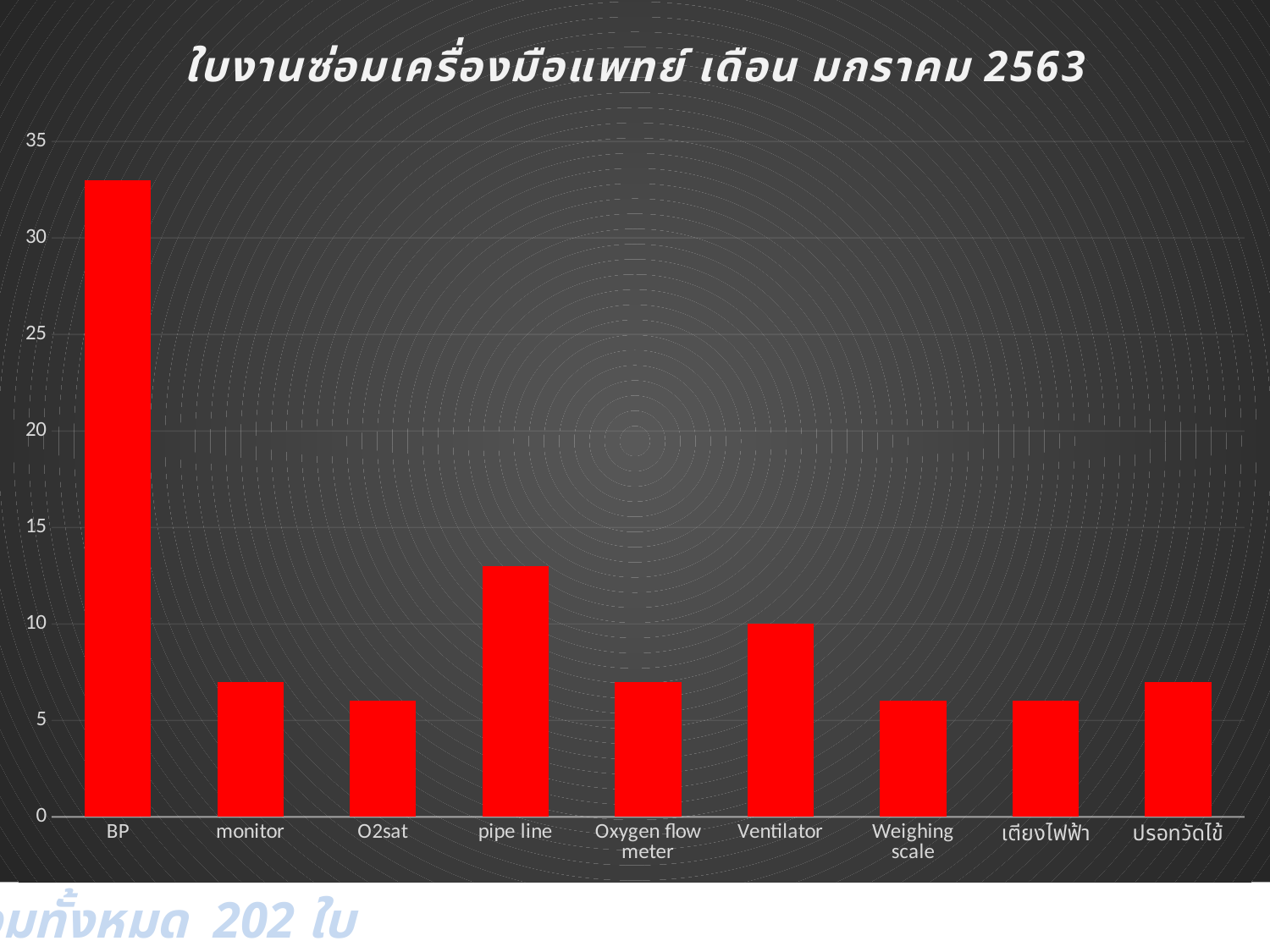
Which is larger, the value for Ventilator or the value for monitor? Ventilator How many categories are shown on the x axis? 9 Which is larger, the value for pipe line or the value for Ventilator? pipe line What type of chart is shown on the slide? Bar chart What is the title of the chart? ใบงานซ่อมเครื่องมือแพทย์ เดือน มกราคม 2563 Is the value for pipe line greater or less than 10? greater Is the value for O2sat greater or less than 5? greater What colour are the bars in the chart? Red Is the value for Weighing scale greater or less than 10? less Which category has the highest value? BP